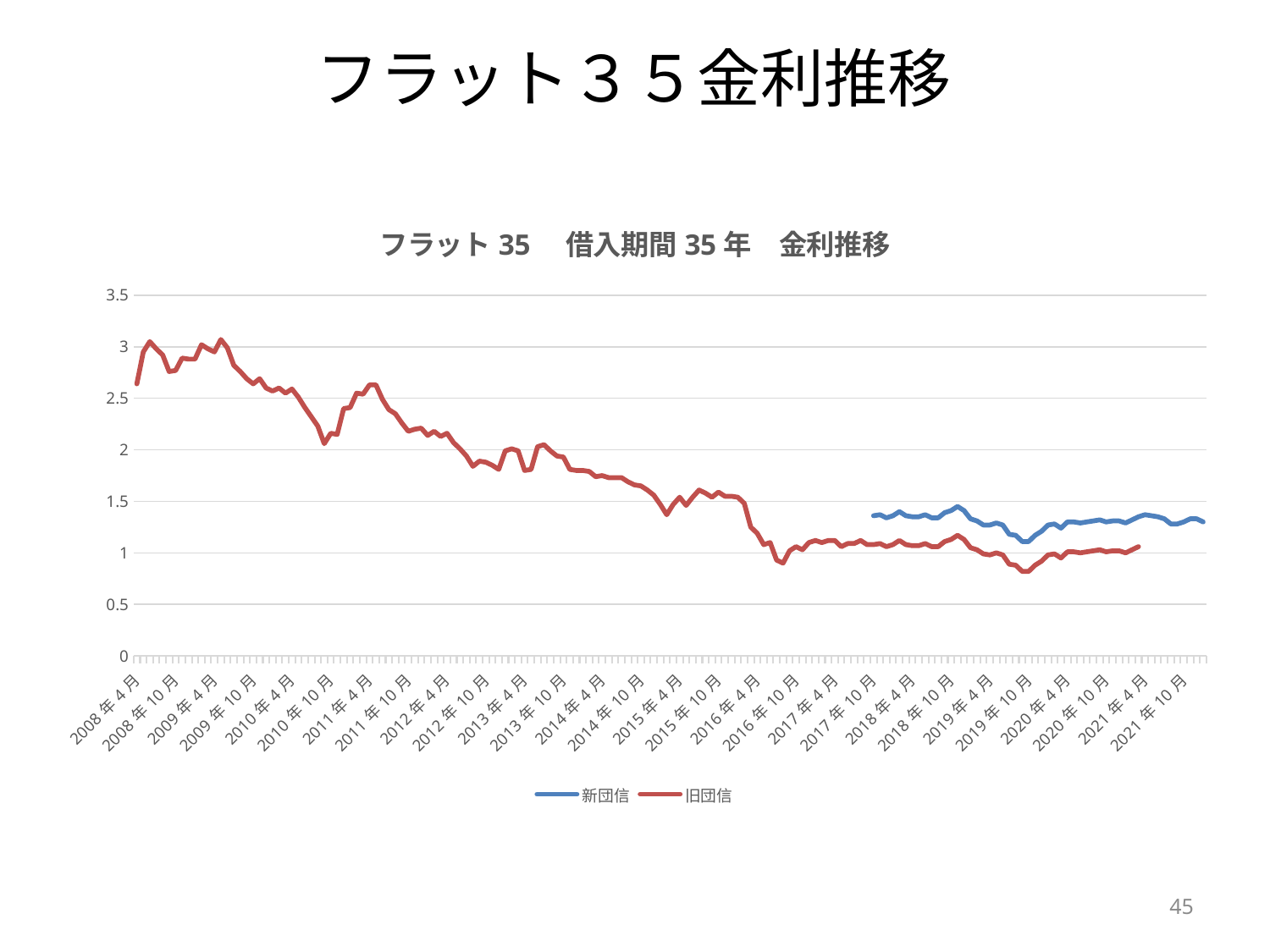
Which colour is used for the 旧団信 series? Red Is the value for 新団信 at 2019年10月 greater or less than 1.5? less Is the value for 旧団信 at 2012年4月 greater or less than 2? greater Does the 旧団信 series generally rise or fall from 2008年4月 to 2021年4月? Fall How many series does the legend list? 2 Is the value for 旧団信 at 2016年10月 greater or less than 1.5? less Which series reaches the highest value anywhere on the chart? 旧団信 What is the title of the chart? フラット35 借入期間35年 金利推移 At 2019年10月, which series has the higher value, 新団信 or 旧団信? 新団信 What kind of chart is shown on the slide? Line chart